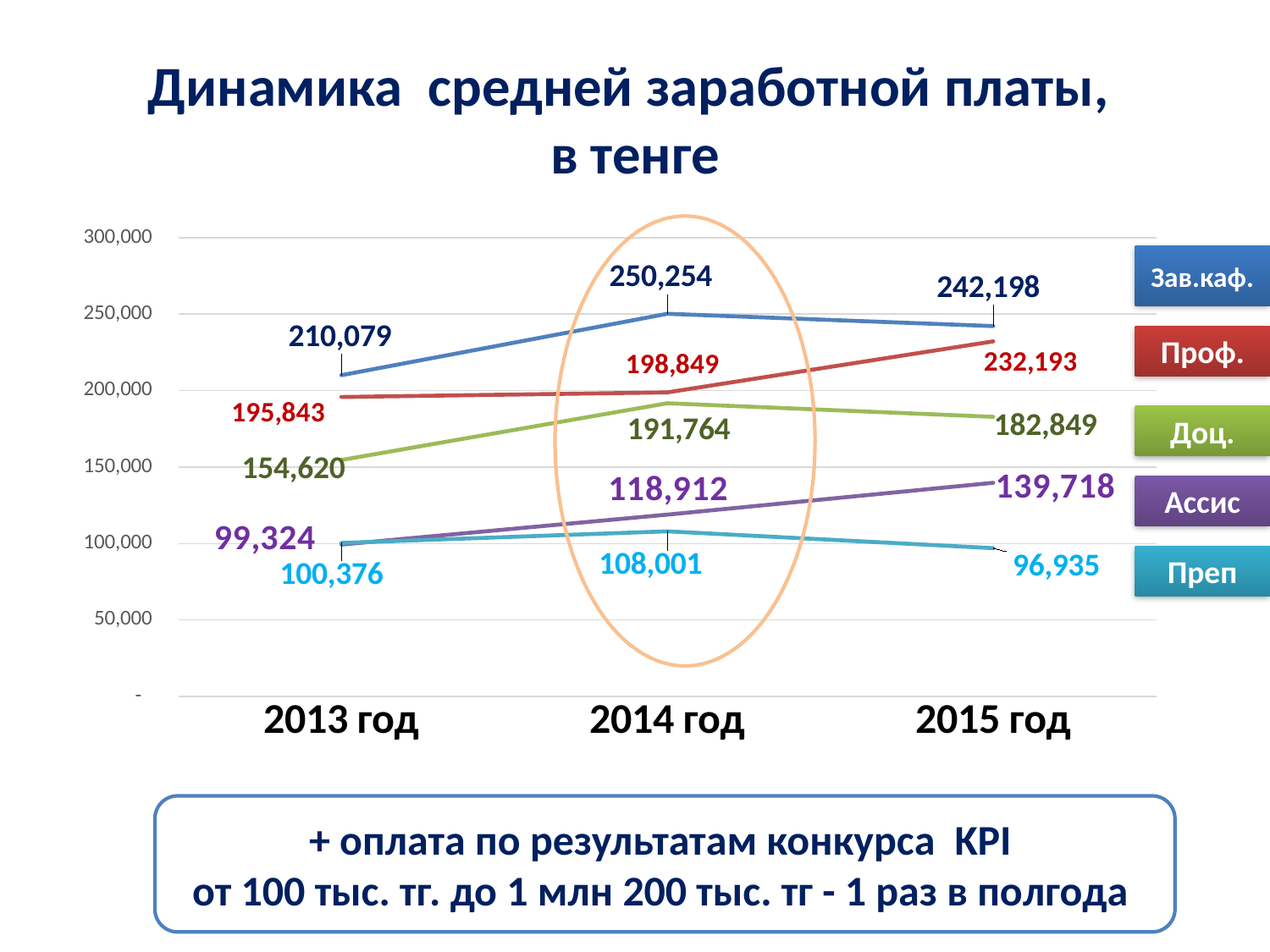
Which is larger in 2014 год: the value for Проф. or the value for Доц.? Проф. What is the value for Преп in 2015 год? 96,935 What kind of chart is shown on the slide? Line chart What is the average salary for Проф. in 2015 год? 232,193 Which category has the highest average salary in 2015 год? Зав.каф. Which category has the lowest average salary in 2015 год? Преп Does the value for Ассис rise or fall from 2013 год to 2015 год? Rise How many series does the legend list? 5 What is the difference between the Зав.каф. values in 2014 год and 2013 год? 40,175 What is the value for Доц. in 2013 год? 154,620 What is the average salary for Зав.каф. in 2014 год? 250,254 How many years are shown on the x axis? 3